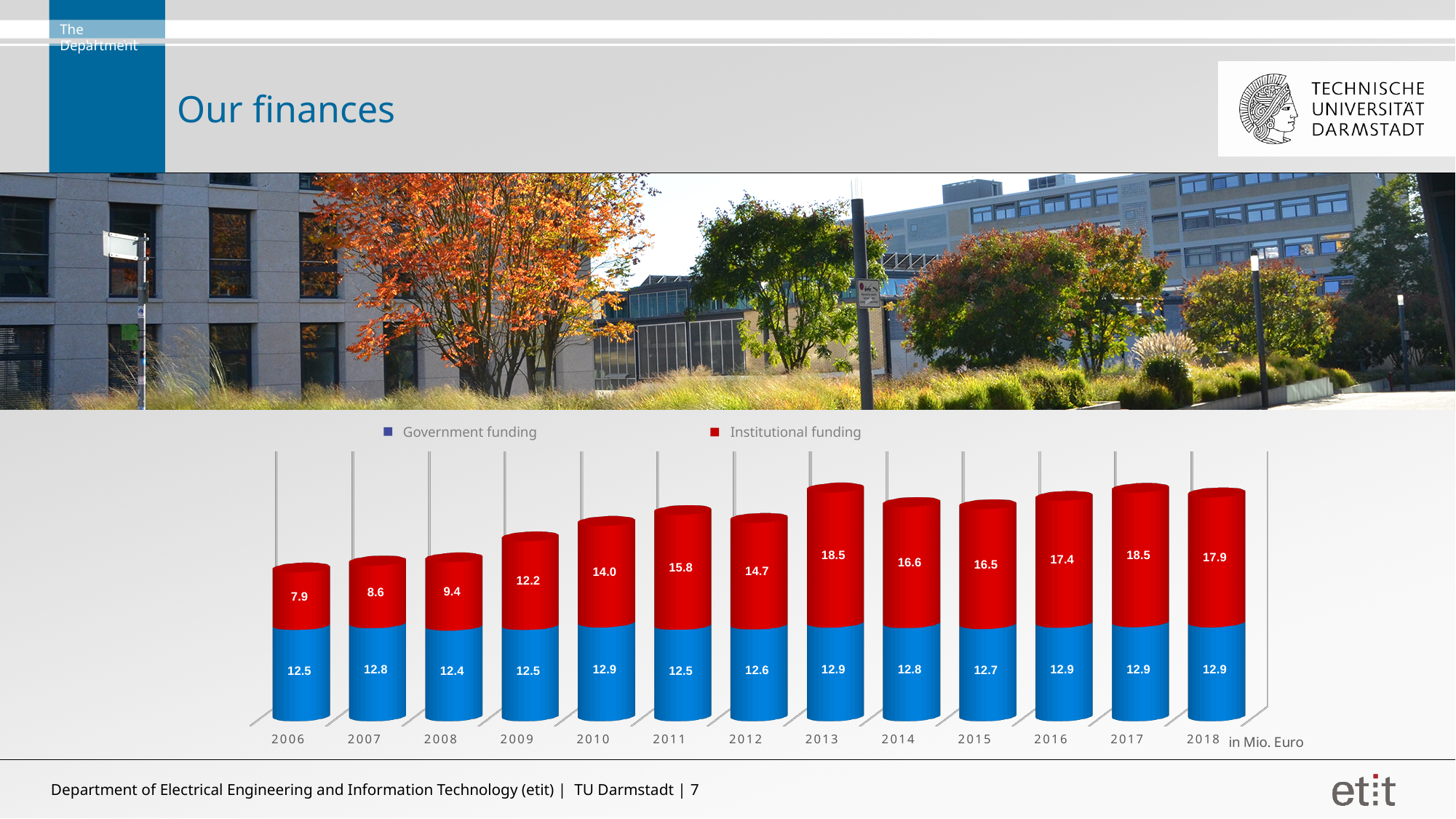
Which year has the lowest Government funding? 2008 How many series does the legend list? 2 What is the Institutional funding value for 2018? 17.9 Which is larger, Institutional funding in 2011 or in 2012? 2011 What is the difference between Institutional funding in 2013 and in 2006? 10.6 How many years are shown on the x axis? 13 What is the Institutional funding value for 2010? 14.0 What kind of chart is shown on the slide? Stacked bar chart What unit is stated for the values in the chart? in Mio. Euro Which year has the lowest Institutional funding? 2006 What is the total funding (Government plus Institutional) for 2006? 20.4 What is the Government funding value for 2008? 12.4